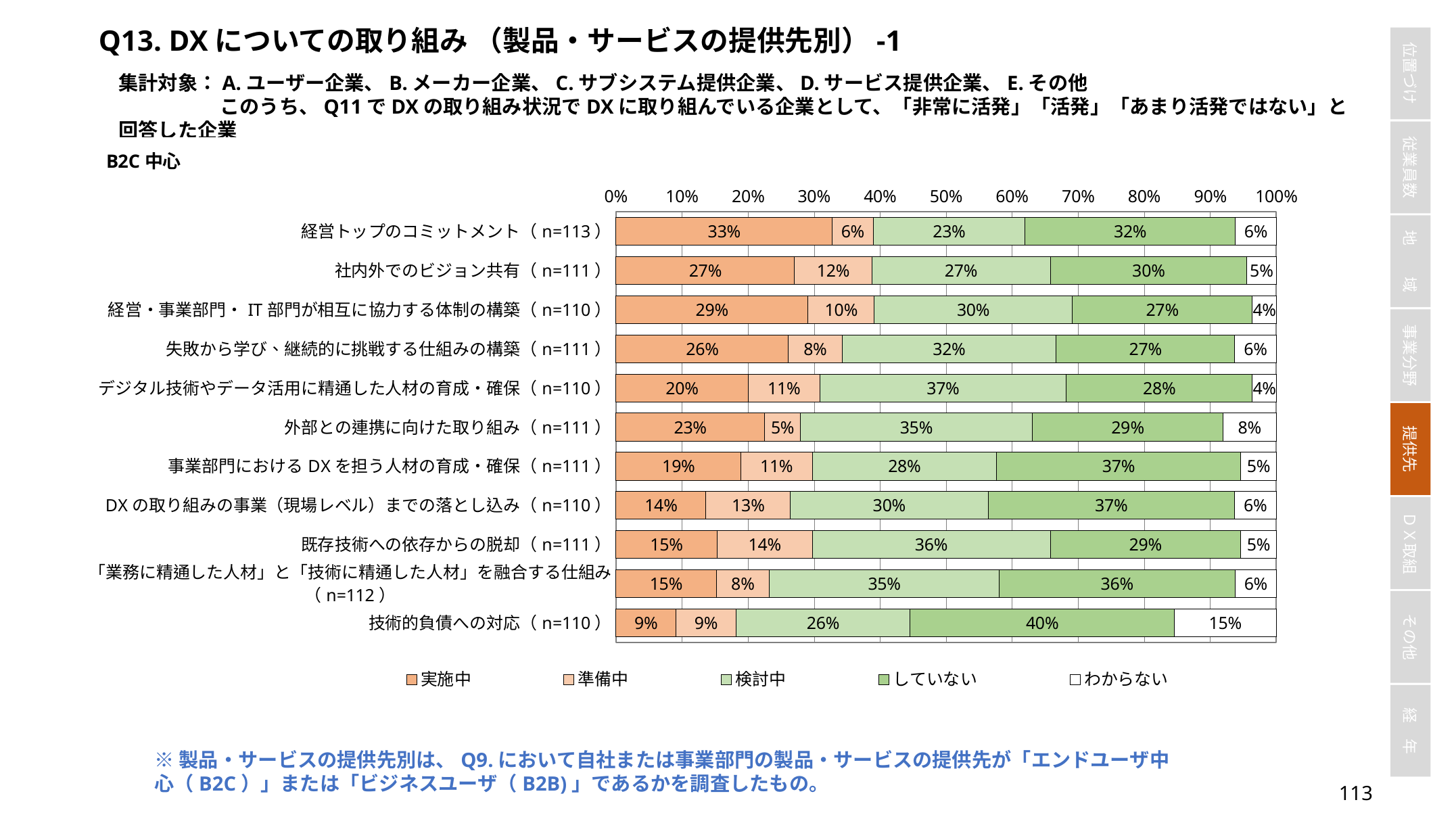
What is the 実施中 value for 経営トップのコミットメント? 33% What is the していない value for 技術的負債への対応? 40% What is the difference between the 実施中 values for 経営トップのコミットメント and 技術的負債への対応? 24% What is the 検討中 value for デジタル技術やデータ活用に精通した人材の育成・確保? 37% How many categories (items) are plotted in the chart? 11 What is the combined 実施中 and 準備中 value for 社内外でのビジョン共有? 39% Which item has the highest わからない value? 技術的負債への対応 How many series does the legend list? 5 Which is larger: the 準備中 value for 既存技術への依存からの脱却 or for 外部との連携に向けた取り組み? 既存技術への依存からの脱却 Which item has the highest 実施中 value? 経営トップのコミットメント What type of chart is shown on the slide? Stacked horizontal bar chart Which item has the lowest 実施中 value? 技術的負債への対応